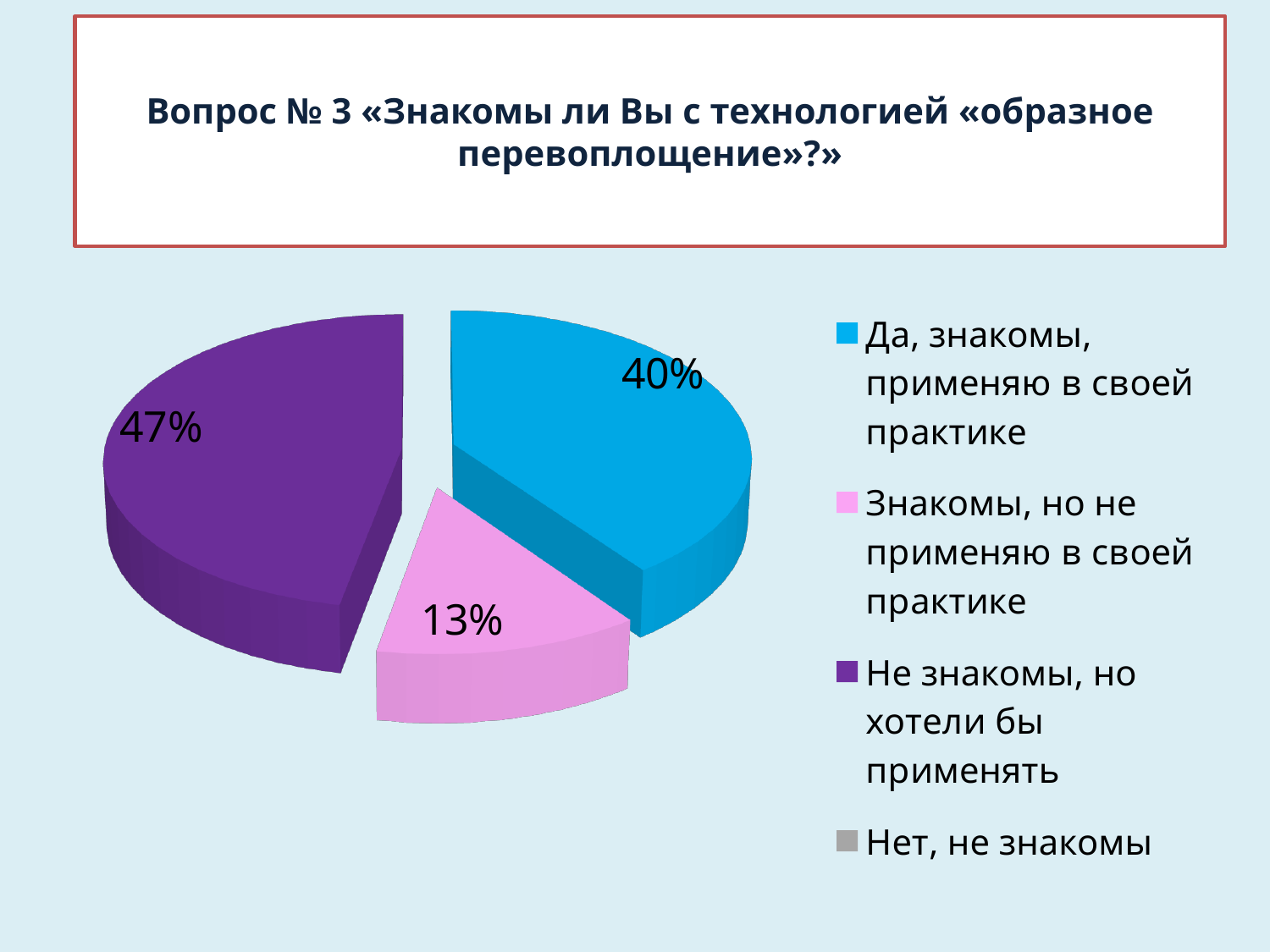
What share of the pie is labelled for "Не знакомы, но хотели бы применять"? 47% What colour is the slice for "Не знакомы, но хотели бы применять"? Purple Which is larger: the share for "Да, знакомы, применяю в своей практике" or the share for "Знакомы, но не применяю в своей практике"? Да, знакомы, применяю в своей практике Which response has the largest share of the pie? Не знакомы, но хотели бы применять What share of the pie is labelled for "Знакомы, но не применяю в своей практике"? 13% What is the title of the chart on the slide? Вопрос № 3 «Знакомы ли Вы с технологией «образное перевоплощение»?» Which of the labelled slices has the smallest share of the pie? Знакомы, но не применяю в своей практике What is the difference in percentage points between the "Да, знакомы, применяю в своей практике" slice and the "Знакомы, но не применяю в своей практике" slice? 27% What is the difference in percentage points between the "Не знакомы, но хотели бы применять" slice and the "Да, знакомы, применяю в своей практике" slice? 7% How many entries does the legend list? 4 What kind of chart is shown on the slide? Pie chart What share of the pie is labelled for "Да, знакомы, применяю в своей практике"? 40%